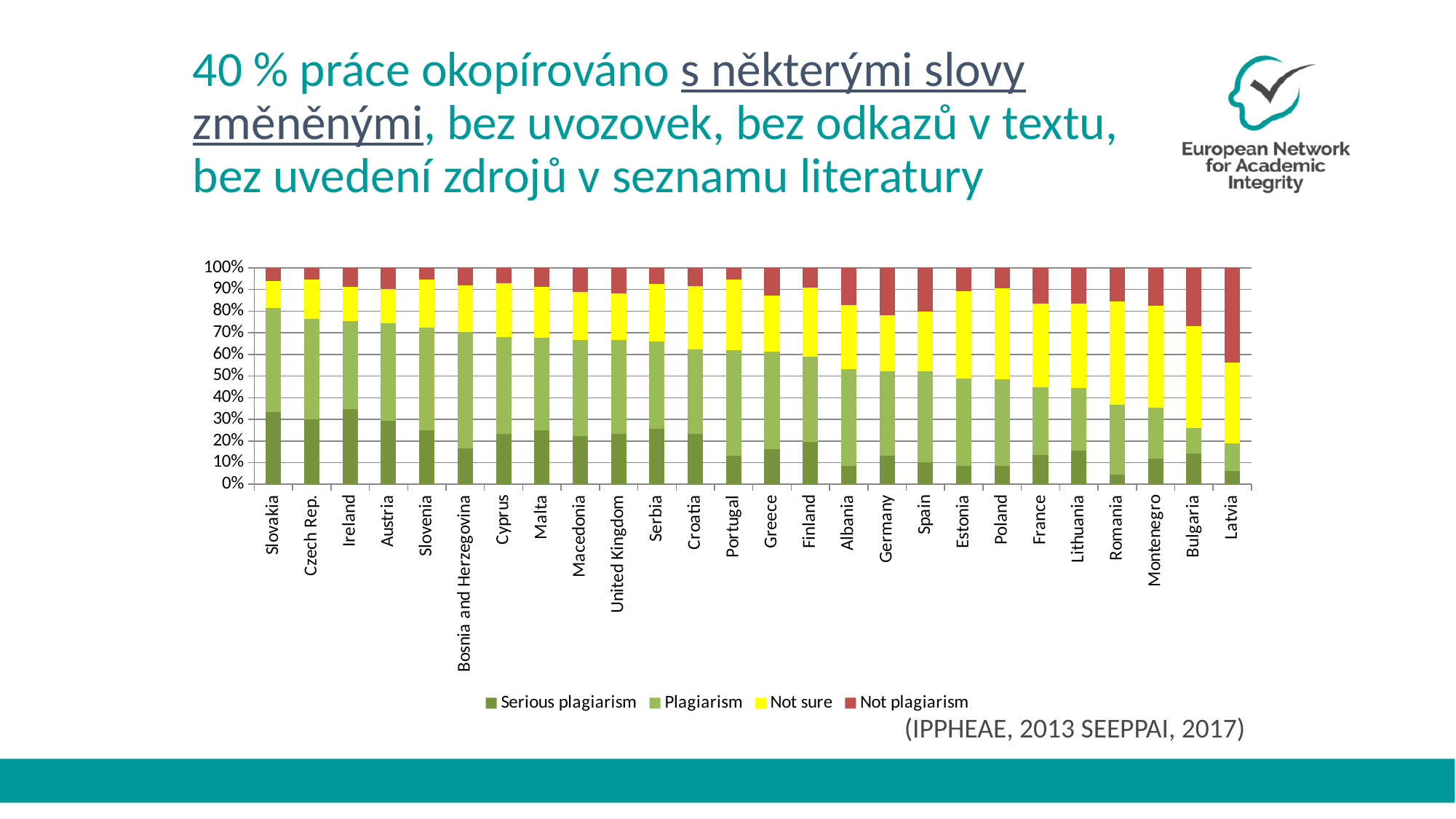
How many series does the chart legend list? 4 Which country has the largest 'Not plagiarism' share? Latvia Does the combined share of 'Serious plagiarism' and 'Plagiarism' generally rise or fall from left to right across the countries? fall How many countries are shown on the x axis of the chart? 26 Which country is the first category on the left of the x axis? Slovakia Which country has the largest combined share of 'Serious plagiarism' and 'Plagiarism'? Slovakia Is the combined share of 'Serious plagiarism' and 'Plagiarism' for Slovakia greater or less than 70%? greater What kind of chart is shown on the slide? stacked bar chart Is the combined share of 'Serious plagiarism' and 'Plagiarism' for Bulgaria greater or less than 30%? less Which series is shown in red in the chart? Not plagiarism Which has the larger 'Serious plagiarism' share, Slovakia or Germany? Slovakia Is the 'Serious plagiarism' share for Romania greater or less than 10%? less